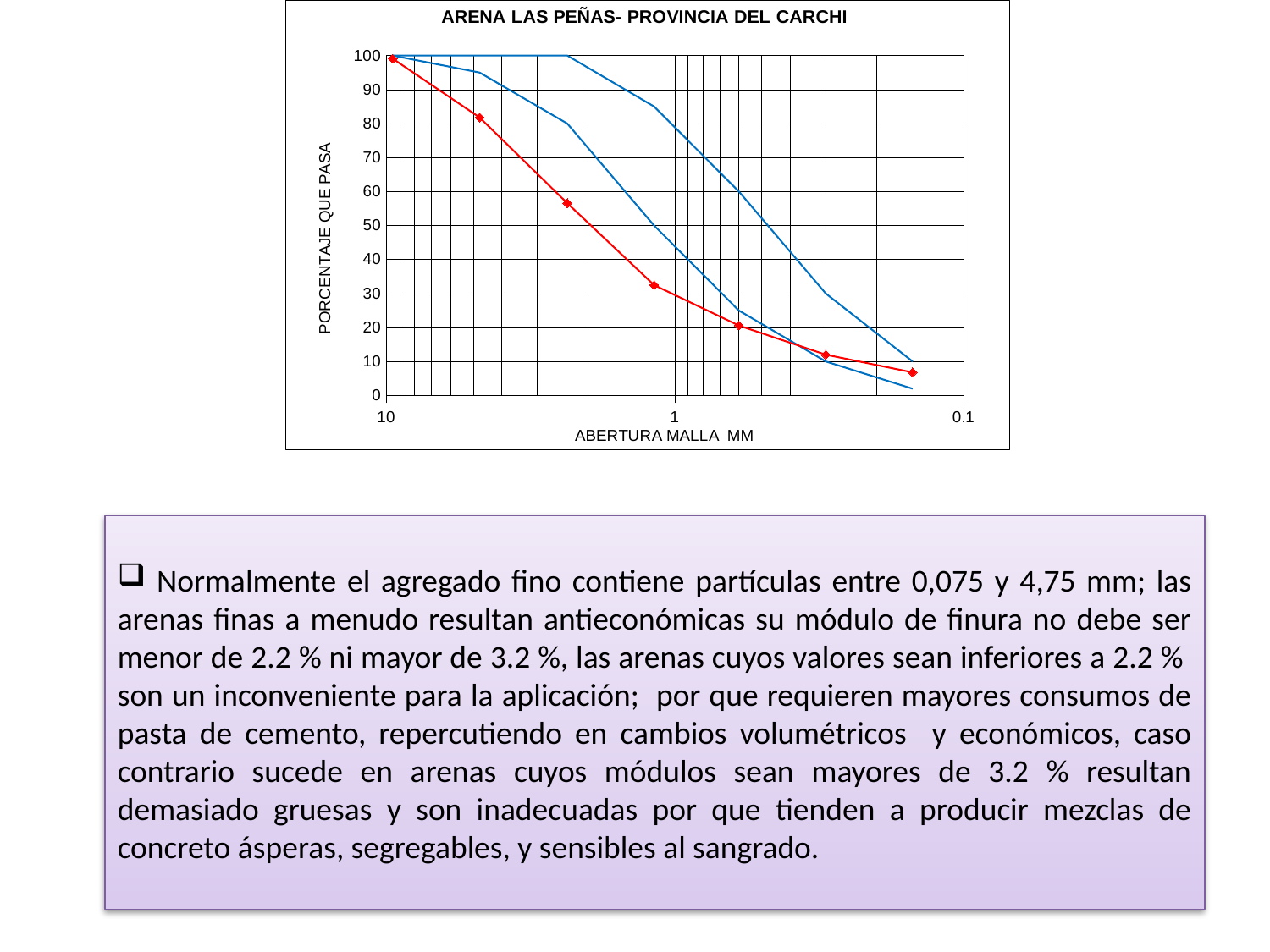
Does the red line rise or fall as the mesh opening decreases from 10 mm to 0.1 mm along the x axis? fall What kind of chart is shown on the slide? line chart At the leftmost point of the chart (10 mm), is the red line's value greater or less than 50? greater What is the highest value shown on the vertical axis of the chart? 100 What is the label of the vertical axis of the chart? PORCENTAJE QUE PASA How many data-point markers are shown on the red line? 7 What is the title of the chart? ARENA LAS PEÑAS- PROVINCIA DEL CARCHI Is the value of the red line at its leftmost point (10 mm) greater or less than 90? greater Is the value of the red line at its rightmost marker greater or less than 10? less How many lines are plotted on the chart? 3